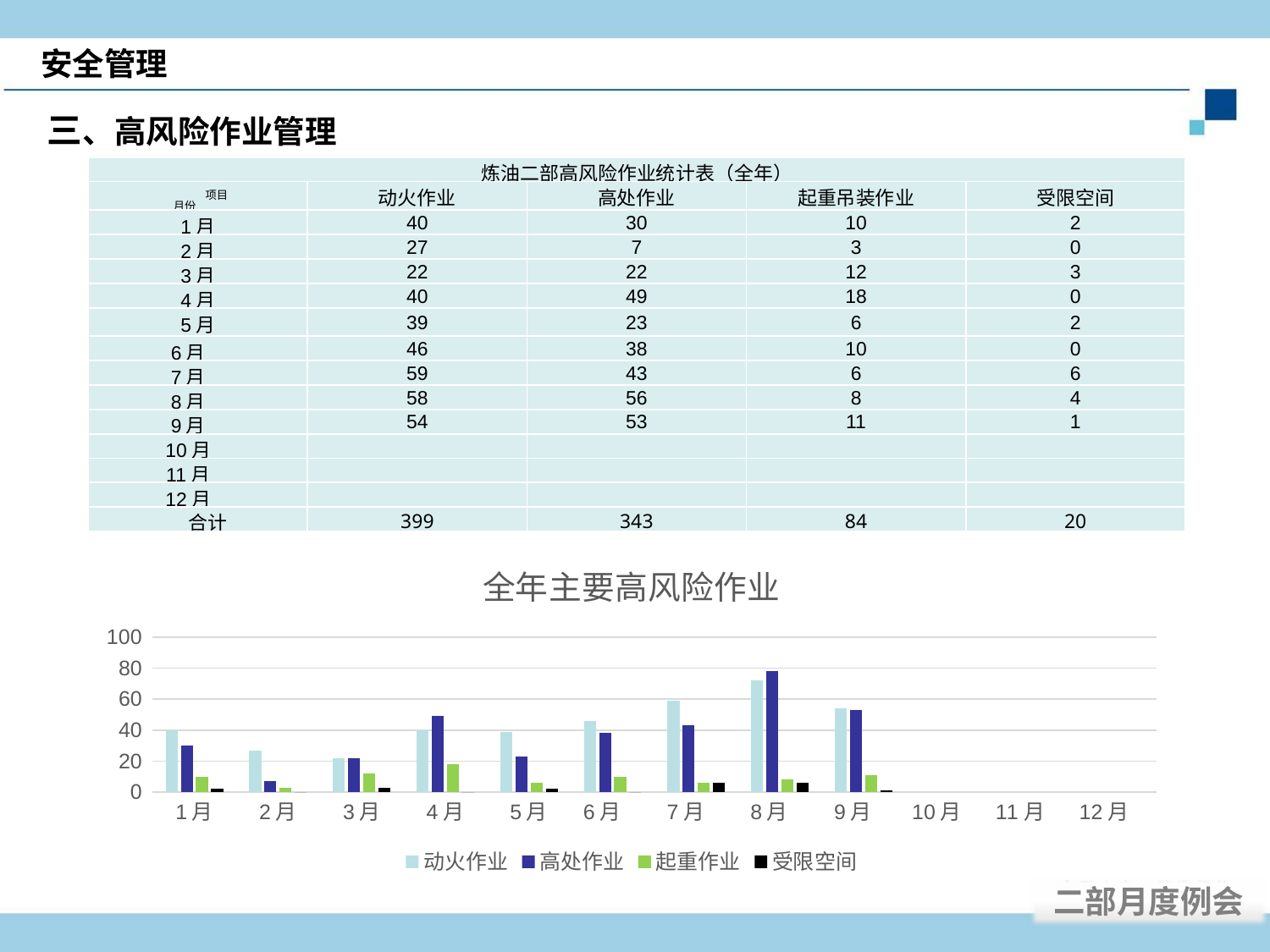
How many series does the legend of the chart list? 4 How many month categories are shown on the x axis of the chart? 12 What is the title of the chart? 全年主要高风险作业 In the chart, which month has the highest 动火作业 bar? 8月 In the chart, is the value for 高处作业 in 4月 greater or less than 40? greater In the chart, which is larger in 1月: 动火作业 or 高处作业? 动火作业 In the chart, is the value for 动火作业 in 8月 greater or less than 60? greater Which series in the chart is drawn in black? 受限空间 What type of chart is shown under the title 全年主要高风险作业? bar chart In the chart, do the 动火作业 bars rise or fall from 5月 to 8月? rise In the chart, is the value for 高处作业 in 2月 greater or less than 20? less